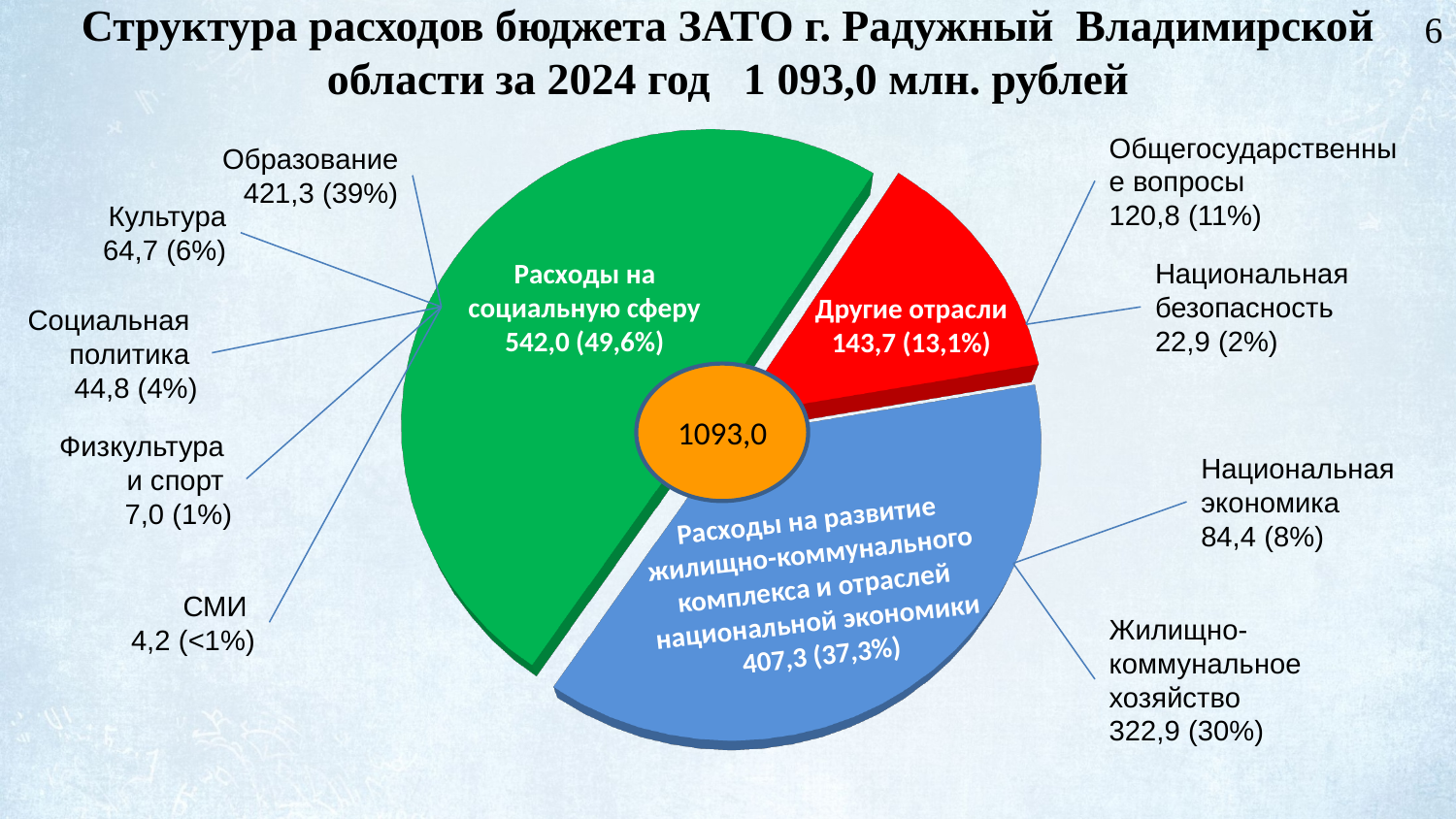
How many slices does the pie chart have? 3 What value is shown for the slice "Расходы на социальную сферу"? 542,0 (49,6%) What share of the pie does the slice "Другие отрасли" represent? 13,1% What value is shown for the slice "Расходы на развитие жилищно-коммунального комплекса и отраслей национальной экономики"? 407,3 (37,3%) Which slice of the pie chart is the largest? Расходы на социальную сферу Which slice of the pie chart is the smallest? Другие отрасли What total value is shown in the centre of the pie chart? 1093,0 What is the difference between the values for "Расходы на социальную сферу" (542,0) and "Другие отрасли" (143,7)? 398,3 What colour is the slice "Другие отрасли"? red What kind of chart is shown on the slide? pie chart Which is larger: "Расходы на социальную сферу" or "Расходы на развитие жилищно-коммунального комплекса и отраслей национальной экономики"? Расходы на социальную сферу What value is shown for the slice "Другие отрасли"? 143,7 (13,1%)